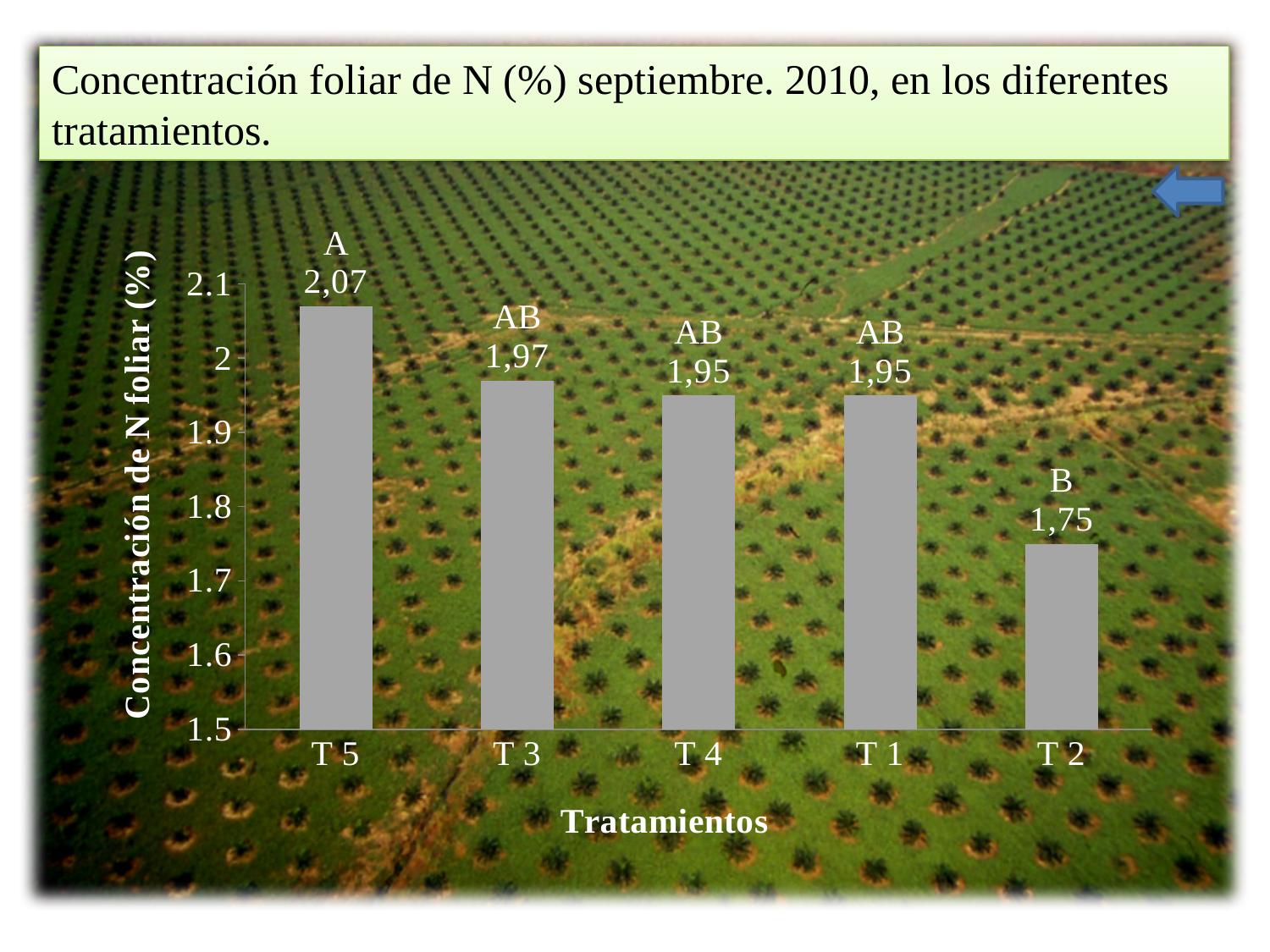
What statistical grouping letter is shown above the bar for T 2? B Is the value for T 2 greater or less than 1.8? less Which treatment has the lowest foliar N concentration? T 2 What is the difference between the values for T 5 and T 2? 0,32 What is the difference between the values for T 3 and T 4? 0,02 What is the foliar N concentration value for T 3? 1,97 Which has a larger value, T 3 or T 2? T 3 What is the foliar N concentration value for T 5? 2,07 Which treatment has the highest foliar N concentration? T 5 What is the foliar N concentration value for T 2? 1,75 What kind of chart is shown on the slide? bar chart How many treatments are shown on the x axis? 5